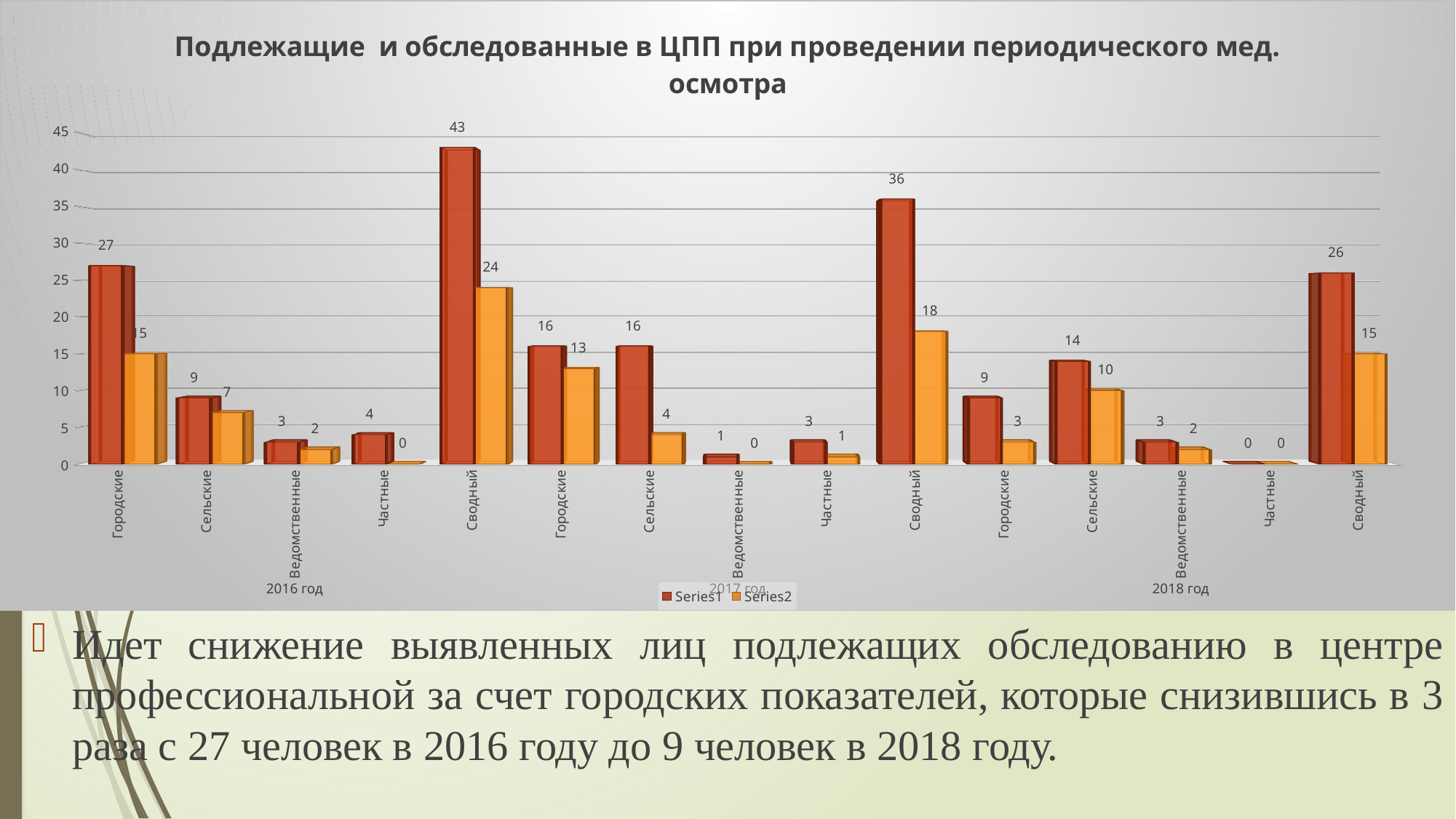
Which category has the highest Series1 value on the chart? Сводный (2016 год) Which is larger: the Series1 value for Сельские in 2017 год or the Series1 value for Сельские in 2018 год? Сельские in 2017 год What are the names of the two series in the legend? Series1 and Series2 What is the Series1 value for Сельские in 2018 год? 14 How does the Series1 value for Сводный change from 2016 год to 2018 год? It falls What is the difference between the Series1 and Series2 values for Сводный in 2016 год? 19 What is the Series2 value for Частные in 2016 год? 0 What is the Series2 value for Сводный in 2017 год? 18 What kind of chart is shown on the slide? Bar chart How many series does the legend list? 2 What is the Series1 value for Городские in 2016 год? 27 What is the difference between the Series1 values for Городские in 2016 год and 2018 год? 18